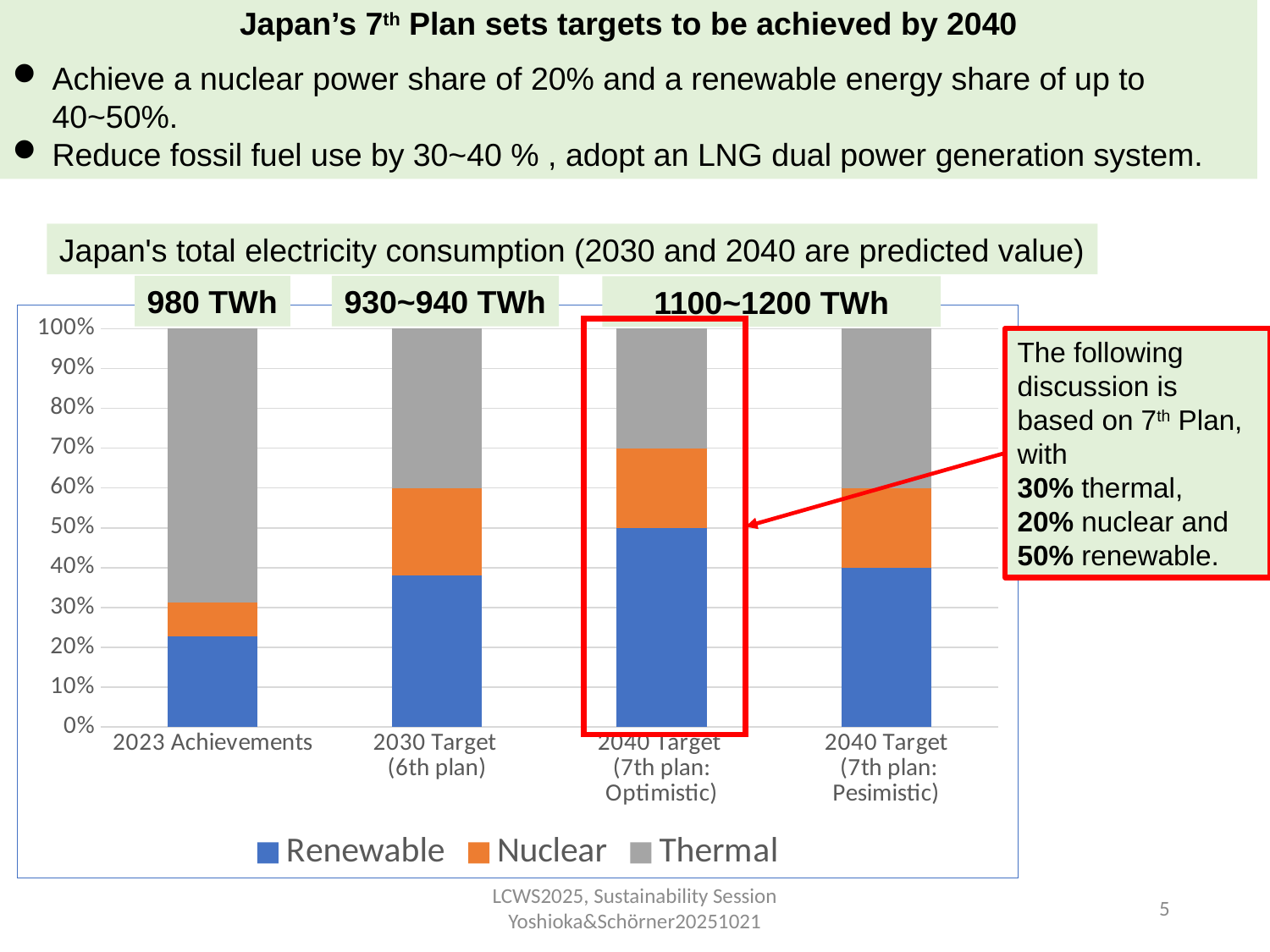
How many categories are shown along the x axis of the chart? 4 Is the renewable share for the 2040 Target (7th plan: Pesimistic) greater or less than 50%? less Which category has the smallest renewable share? 2023 Achievements What kind of chart is shown on the slide? Stacked bar chart How many series does the chart legend list? 3 What is the thermal share for the 2040 Target (7th plan: Optimistic)? 30% What are the three series listed in the chart legend? Renewable, Nuclear, Thermal What is the nuclear share for the 2040 Target (7th plan: Optimistic)? 20% Which category has the largest renewable share? 2040 Target (7th plan: Optimistic) Is the renewable share for 2023 Achievements greater or less than 30%? less Which category has the largest thermal share? 2023 Achievements What is the renewable share for the 2040 Target (7th plan: Optimistic)? 50%